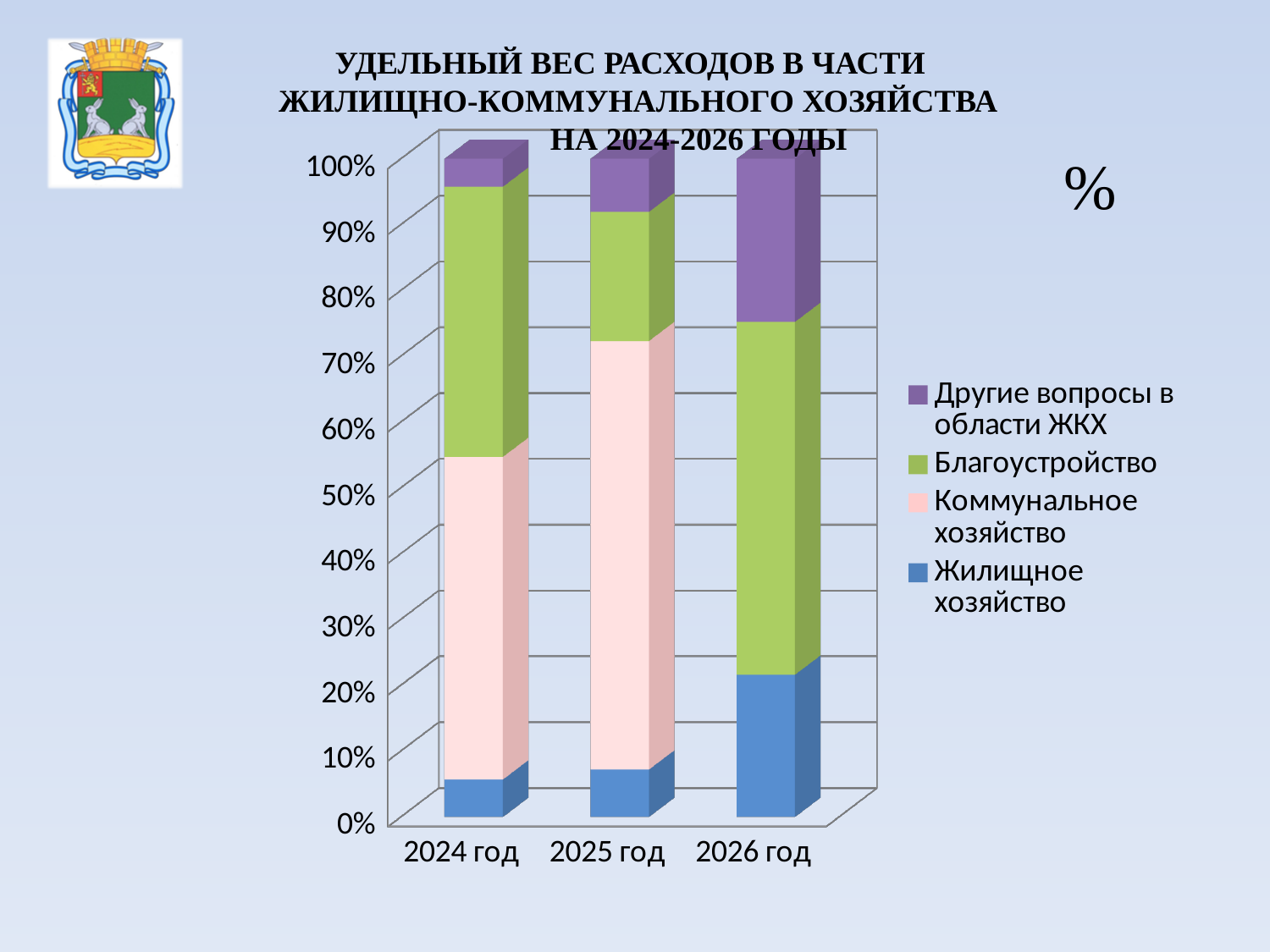
What is the title of the chart? УДЕЛЬНЫЙ ВЕС РАСХОДОВ В ЧАСТИ ЖИЛИЩНО-КОММУНАЛЬНОГО ХОЗЯЙСТВА НА 2024-2026 ГОДЫ Is the share of Жилищное хозяйство in 2026 год greater or less than 10%? greater Which series is shown in green in the chart legend? Благоустройство Does the share of Жилищное хозяйство rise or fall from 2024 год to 2026 год? rise What kind of chart is shown on the slide? Stacked bar chart How many years (categories) are shown on the x axis of the chart? 3 How many series does the chart legend list? 4 Is the share of Коммунальное хозяйство in 2025 год greater or less than 50%? greater In which year is the share of Жилищное хозяйство the highest? 2026 год Is the share of Благоустройство in 2025 год greater or less than 30%? less Which year has the larger share of Коммунальное хозяйство, 2024 год or 2025 год? 2025 год